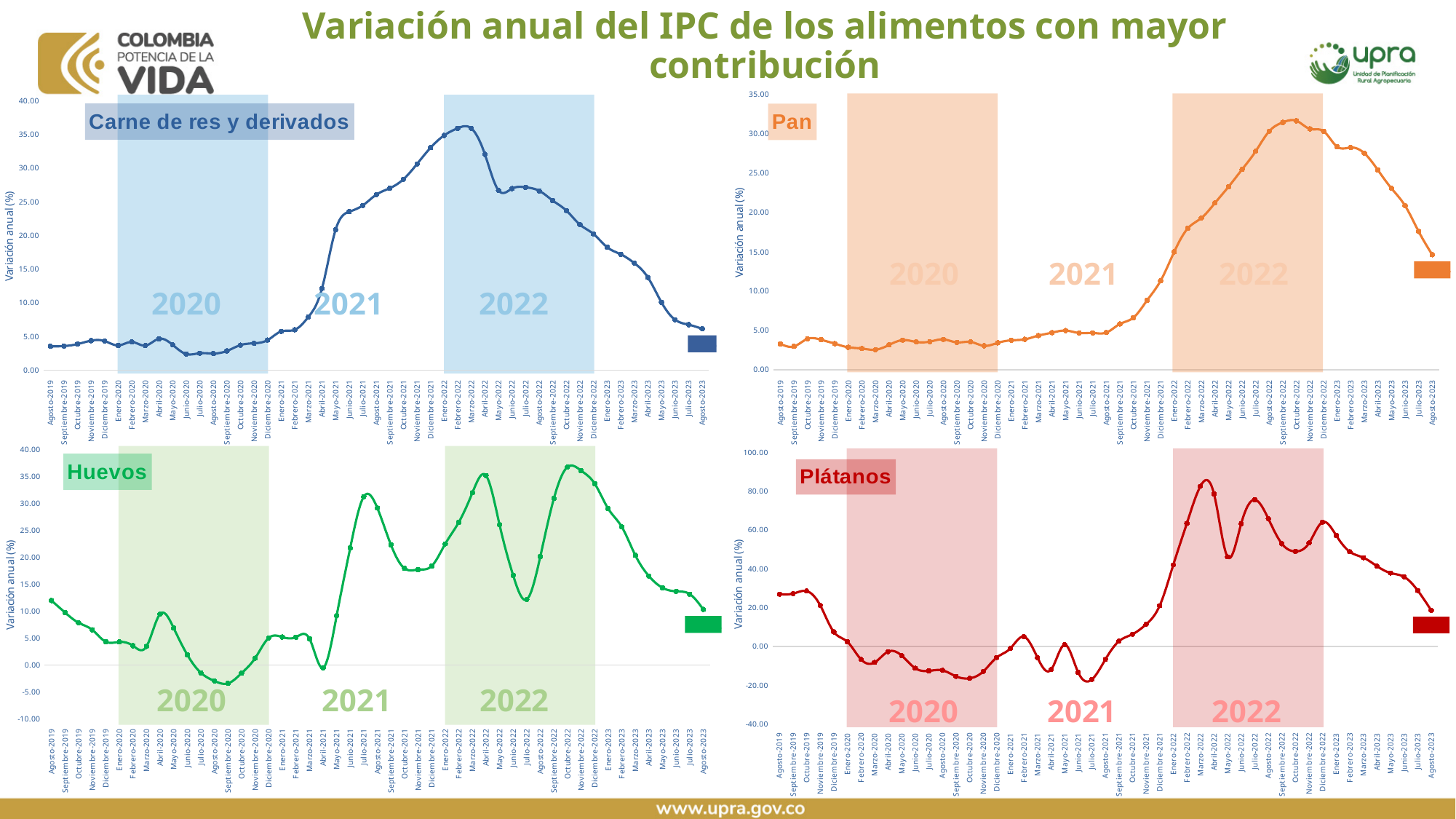
In the 'Pan' chart, is the value for Agosto-2023 greater or less than 20? less In the 'Carne de res y derivados' chart, is the value for Marzo-2022 greater or less than 35? greater In the 'Pan' chart, is the value for Octubre-2022 greater or less than 30? greater How many charts are shown on the slide? 4 In the 'Carne de res y derivados' chart, do the values rise or fall from Marzo-2022 to Agosto-2023? fall What kind of chart is used for 'Carne de res y derivados'? line chart In the 'Pan' chart, do the values rise or fall from Enero-2022 to Octubre-2022? rise In the 'Huevos' chart, which is larger, the value for Agosto-2019 or the value for Septiembre-2020? Agosto-2019